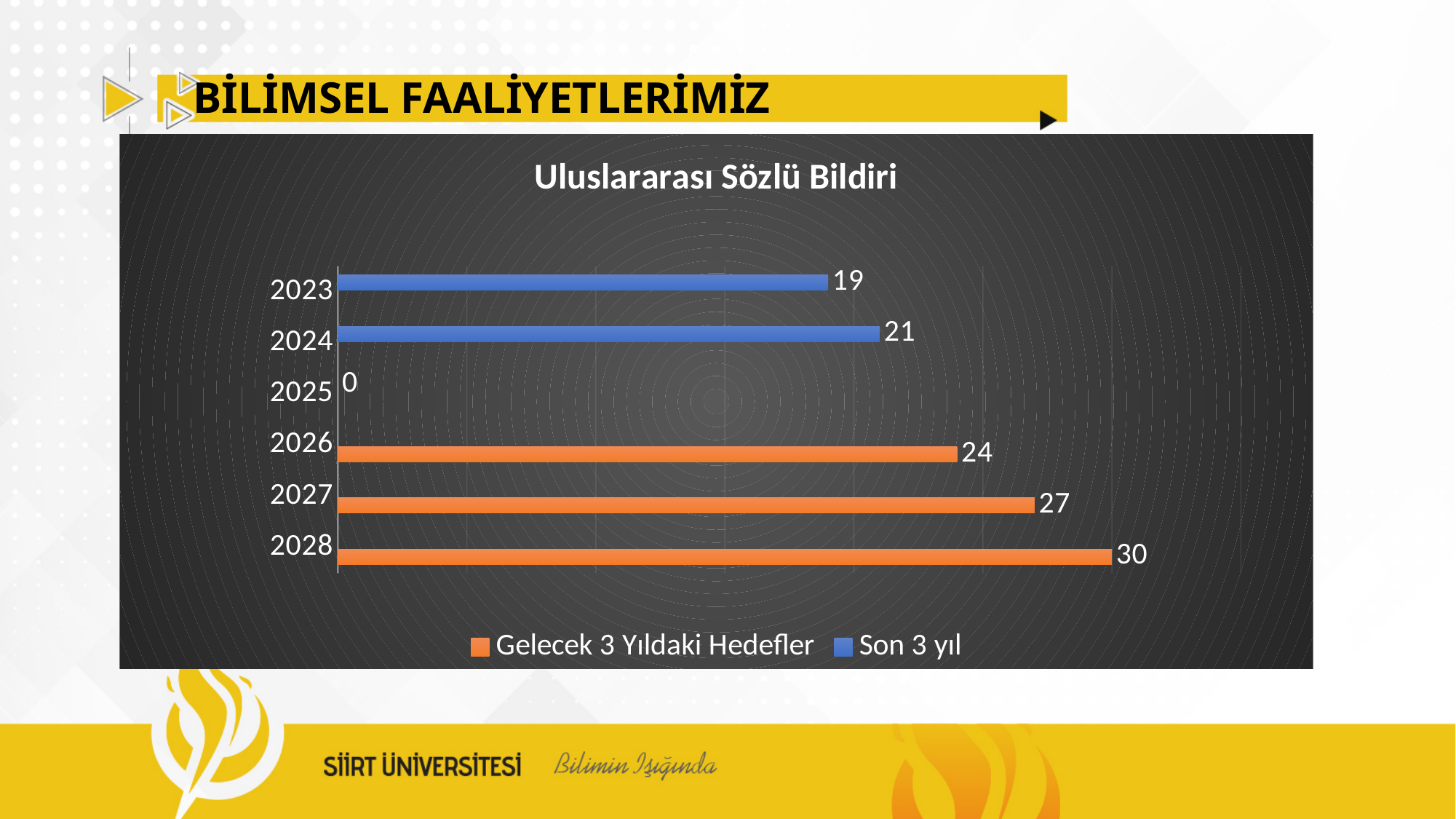
What kind of chart is the Uluslararası Sözlü Bildiri chart? Bar chart What is the value for 2023 in the Uluslararası Sözlü Bildiri chart? 19 Which year has the highest value in the Uluslararası Sözlü Bildiri chart? 2028 What is the value for 2025 in the Uluslararası Sözlü Bildiri chart? 0 Which series in the Uluslararası Sözlü Bildiri chart is shown in orange? Gelecek 3 Yıldaki Hedefler How many years are shown on the axis of the Uluslararası Sözlü Bildiri chart? 6 How many series does the legend of the Uluslararası Sözlü Bildiri chart list? 2 What is the difference between the values for 2028 and 2026 in the Uluslararası Sözlü Bildiri chart? 6 Which is larger in the Uluslararası Sözlü Bildiri chart, the value for 2024 or the value for 2027? 2027 Which year has the lowest value in the Uluslararası Sözlü Bildiri chart? 2025 What is the value for 2028 in the Uluslararası Sözlü Bildiri chart? 30 What is the value for 2024 in the Uluslararası Sözlü Bildiri chart? 21